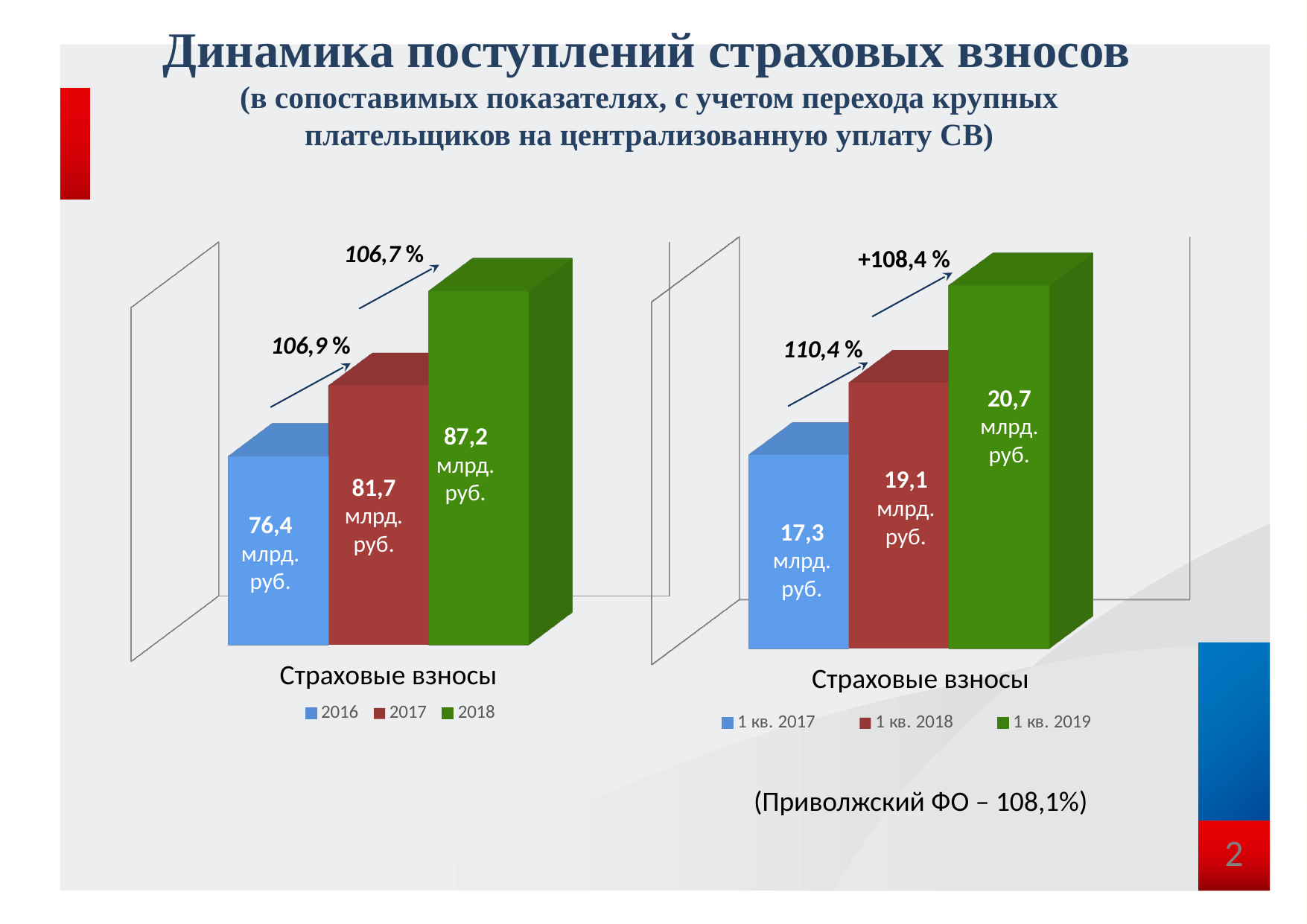
In the left chart, what is the difference between the 2018 and 2016 values? 10,8 млрд. руб. What type of chart is the left chart? Bar chart In the left chart, what is the value for 2018? 87,2 млрд. руб. In the left chart, which is larger: the value for 2017 or the value for 2018? 2018 In the left chart, which year has the highest value? 2018 How many series does the legend of the right chart list? 3 In the left chart, what growth percentage is shown between 2016 and 2017? 106,9 % In the left chart, what is the value for 2016? 76,4 млрд. руб. In the right chart, what is the difference between the 1 кв. 2019 and 1 кв. 2017 values? 3,4 млрд. руб. In the right chart, what is the value for 1 кв. 2018? 19,1 млрд. руб. In the right chart, which period has the lowest value? 1 кв. 2017 In the right chart, what is the value for 1 кв. 2019? 20,7 млрд. руб.